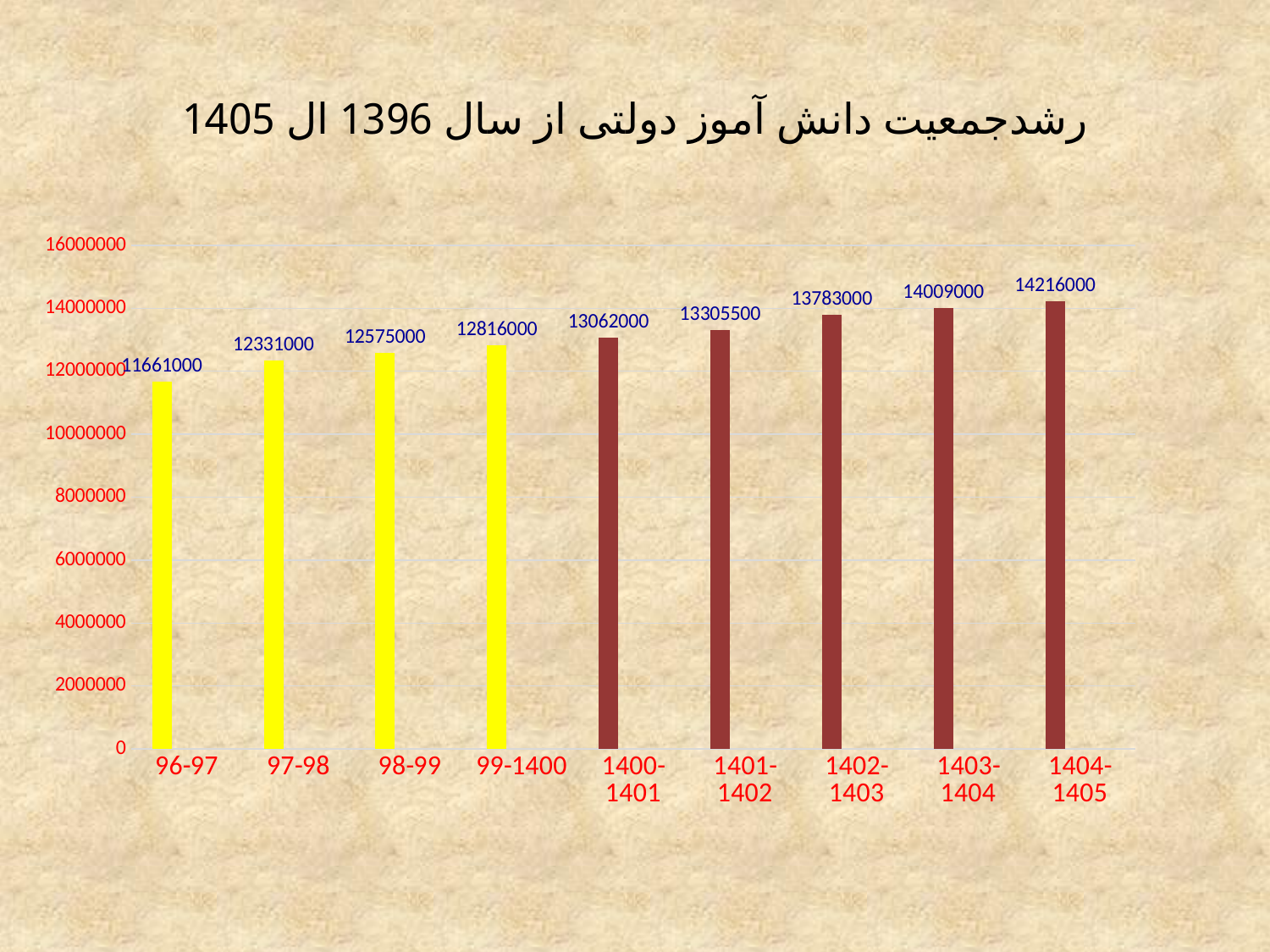
What is the difference between the values for 1404-1405 and 96-97? 2555000 How many categories are shown on the x axis? 9 Which category has the highest value? 1404-1405 Is the value for 1402-1403 greater or less than 14000000? less What is the value for 1401-1402? 13305500 What is the value for 96-97? 11661000 What kind of chart is shown on the slide? bar chart What is the difference between the values for 1403-1404 and 1402-1403? 226000 Which is larger, the value for 98-99 or the value for 1400-1401? 1400-1401 What is the value for 99-1400? 12816000 Do the values rise or fall from left to right along the x axis? rise Which category has the lowest value? 96-97